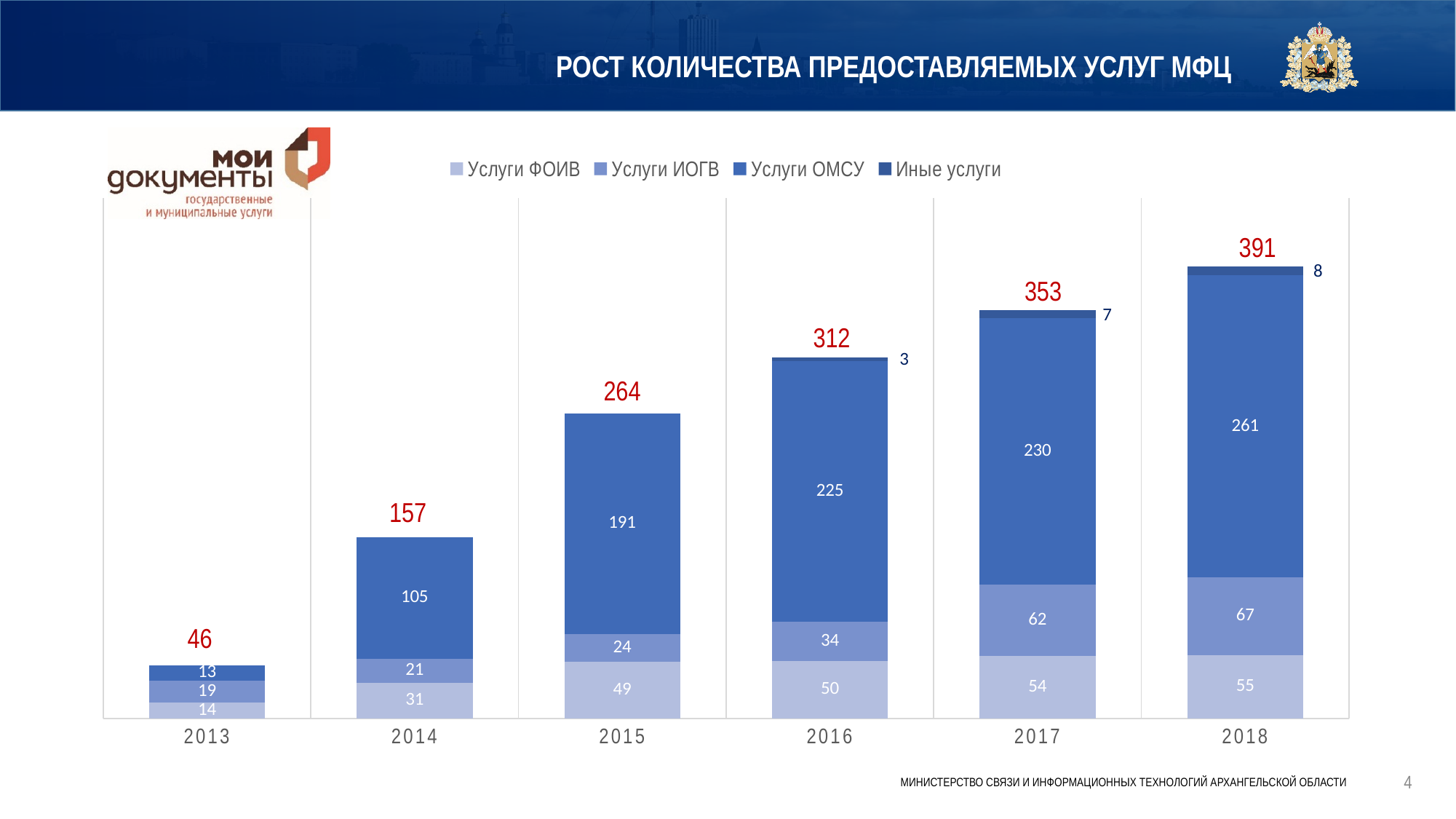
Which is larger: Услуги ИОГВ in 2017 or Услуги ИОГВ in 2016? Услуги ИОГВ in 2017 Which year has the lowest total number of services? 2013 How many years are shown on the x axis? 6 Which year has the highest total number of services? 2018 Do the total values rise or fall from 2013 to 2018? rise What is the value of Иные услуги in 2017? 7 What is the value of Услуги ФОИВ in 2014? 31 What is the value of Услуги ОМСУ in 2016? 225 What is the total number of services shown above the bar for 2018? 391 What is the difference between the totals for 2015 and 2014? 107 What type of chart is shown on the slide? stacked bar chart How many series does the legend list? 4